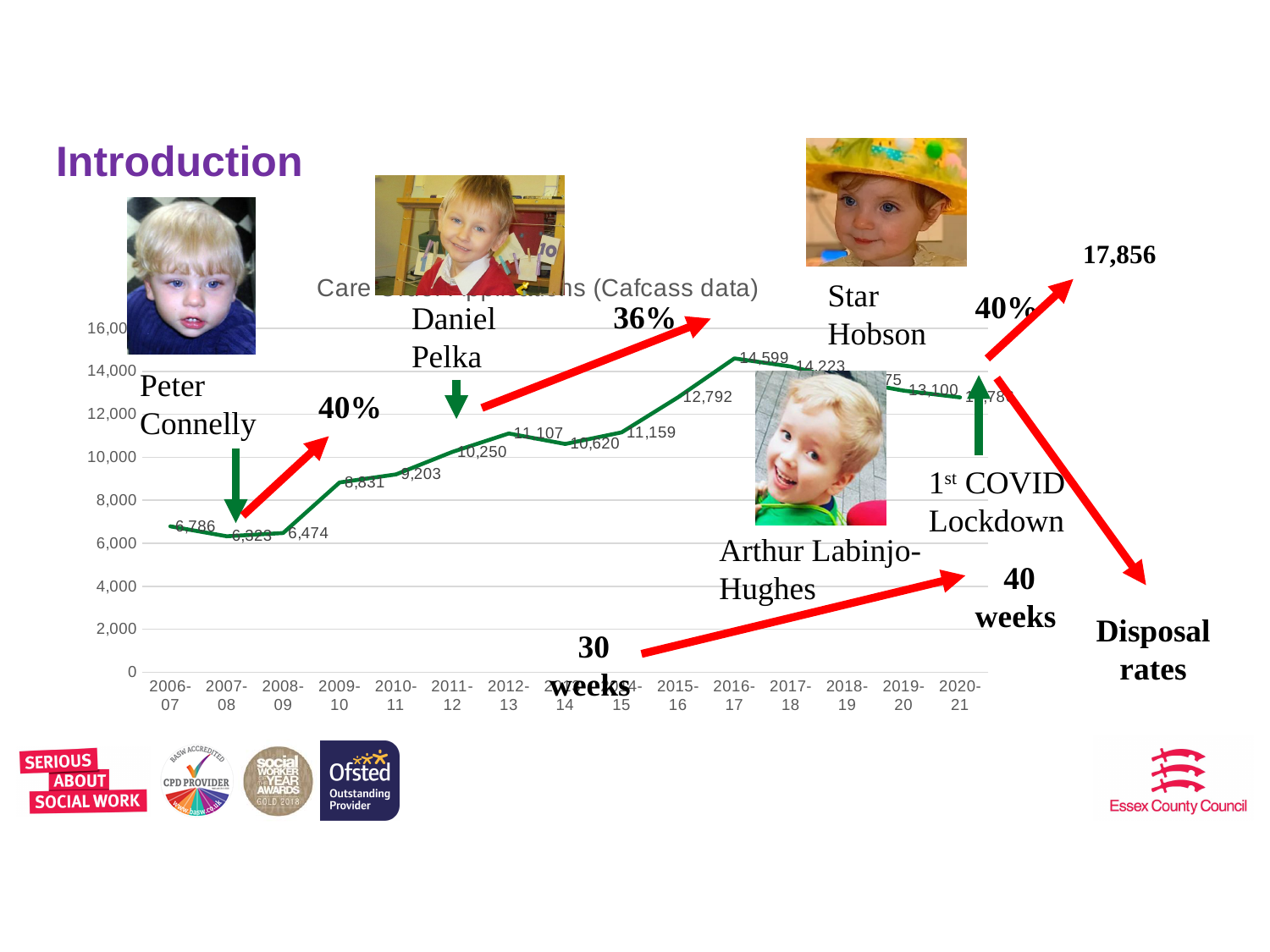
What is the value for 2015-16? 12,792 How many years are shown on the x axis? 15 What is the difference between the values for 2016-17 and 2015-16? 1,807 What is the value for 2007-08? 6,323 Which year has the highest value? 2016-17 What is the value for 2019-20? 13,100 Is the value for 2009-10 greater or less than 8,000? greater Which year has the lowest value? 2007-08 What is the value for 2006-07? 6,786 What is the value for 2011-12? 10,250 Which is larger, the value for 2012-13 or the value for 2013-14? 2012-13 What type of chart is shown on the slide? line chart